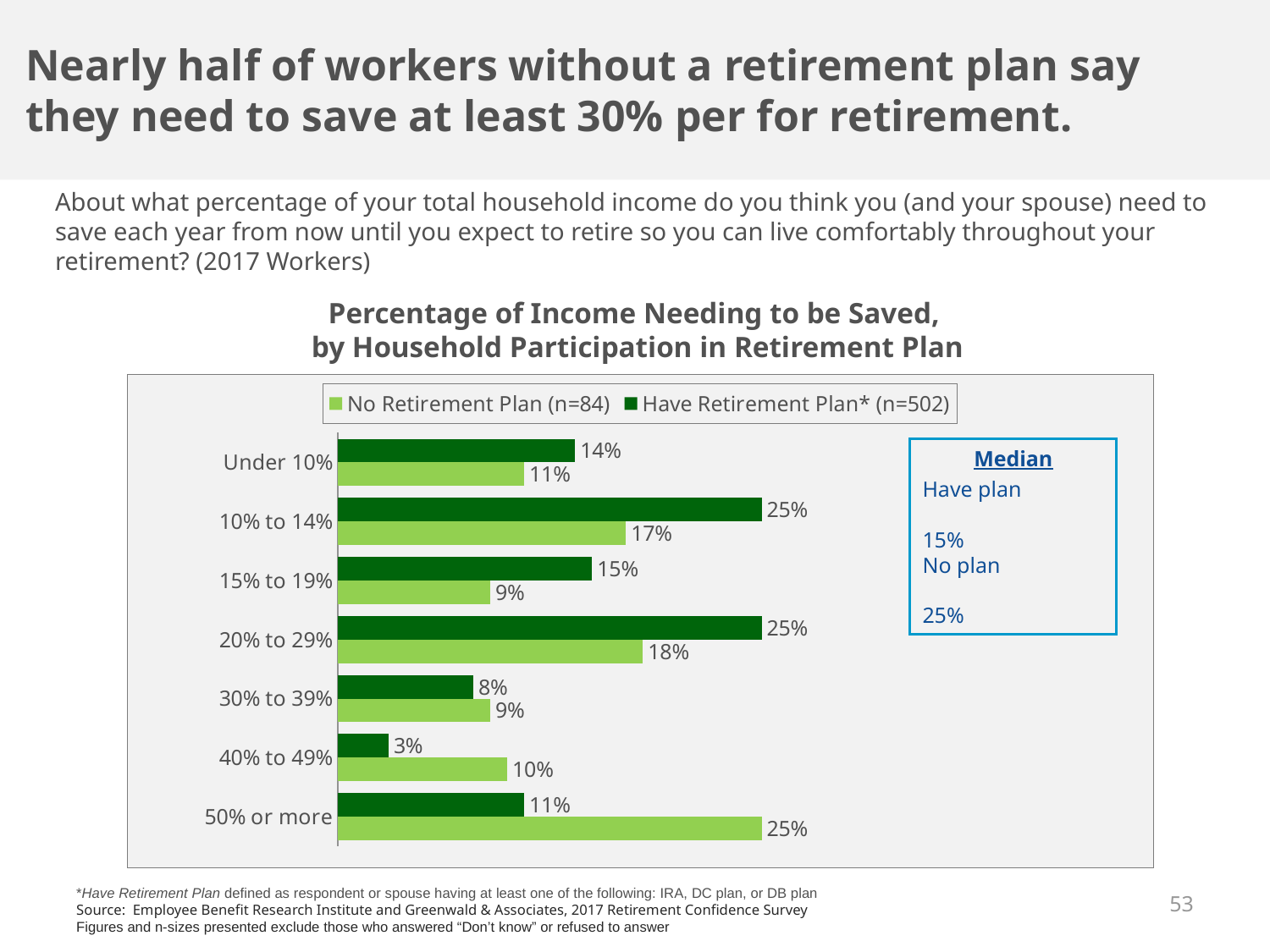
What percentage of workers with a retirement plan say they need to save 10% to 14% of income? 25% What is the value for the Have Retirement Plan series in the 30% to 39% category? 8% What type of chart is shown on the slide? Bar chart Which category has the lowest value for the Have Retirement Plan series? 40% to 49% In the 50% or more category, which series has the larger value? No Retirement Plan (n=84) What is the value for the No Retirement Plan series in the 40% to 49% category? 10% How many series does the legend list? 2 How many savings-percentage categories are shown on the chart? 7 Which category has the highest value for the No Retirement Plan series? 50% or more What percentage of workers with no retirement plan say they need to save 50% or more? 25% What is the difference between the Have Retirement Plan and No Retirement Plan values in the 20% to 29% category? 7% According to the box on the chart, what is the median percentage of income needing to be saved for those with no plan? 25%